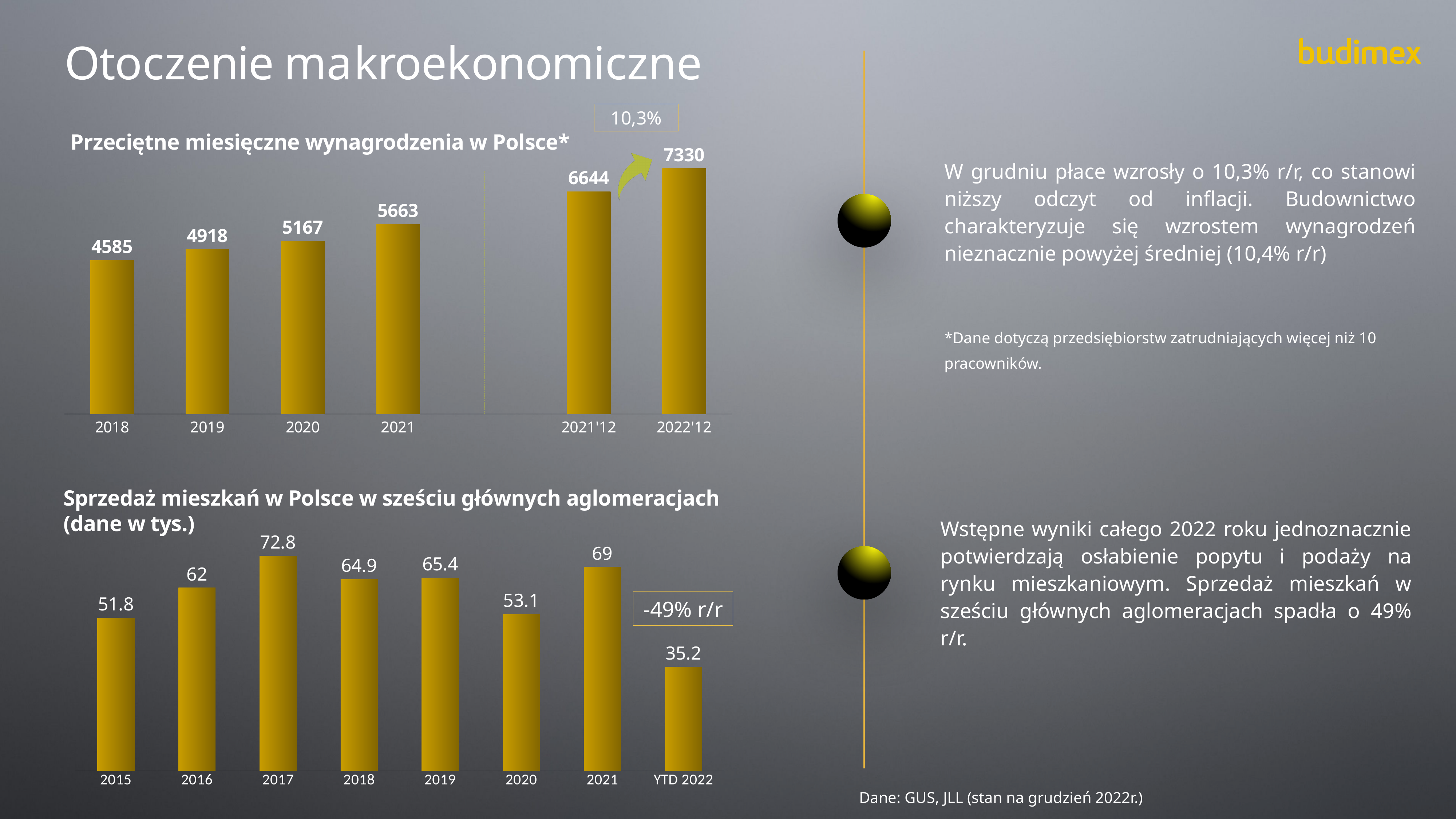
In the chart 'Przeciętne miesięczne wynagrodzenia w Polsce*', what is the value for 2022'12? 7330 In the chart 'Sprzedaż mieszkań w Polsce w sześciu głównych aglomeracjach (dane w tys.)', which category has the highest value? 2017 In the chart 'Przeciętne miesięczne wynagrodzenia w Polsce*', do the values rise or fall from 2018 to 2021? rise In the chart 'Przeciętne miesięczne wynagrodzenia w Polsce*', which category has the lowest value? 2018 In the chart 'Sprzedaż mieszkań w Polsce w sześciu głównych aglomeracjach (dane w tys.)', what is the value for YTD 2022? 35.2 In the chart 'Przeciętne miesięczne wynagrodzenia w Polsce*', how many bars are shown? 6 In the chart 'Sprzedaż mieszkań w Polsce w sześciu głównych aglomeracjach (dane w tys.)', which is larger, the value for 2019 or the value for 2020? 2019 In the chart 'Przeciętne miesięczne wynagrodzenia w Polsce*', what is the difference between the values for 2022'12 and 2021'12? 686 In the chart 'Sprzedaż mieszkań w Polsce w sześciu głównych aglomeracjach (dane w tys.)', what is the difference between the values for 2021 and YTD 2022? 33.8 In the chart 'Przeciętne miesięczne wynagrodzenia w Polsce*', what is the value for 2020? 5167 In the chart 'Sprzedaż mieszkań w Polsce w sześciu głównych aglomeracjach (dane w tys.)', what is the value for 2017? 72.8 What type of chart is 'Sprzedaż mieszkań w Polsce w sześciu głównych aglomeracjach (dane w tys.)'? bar chart